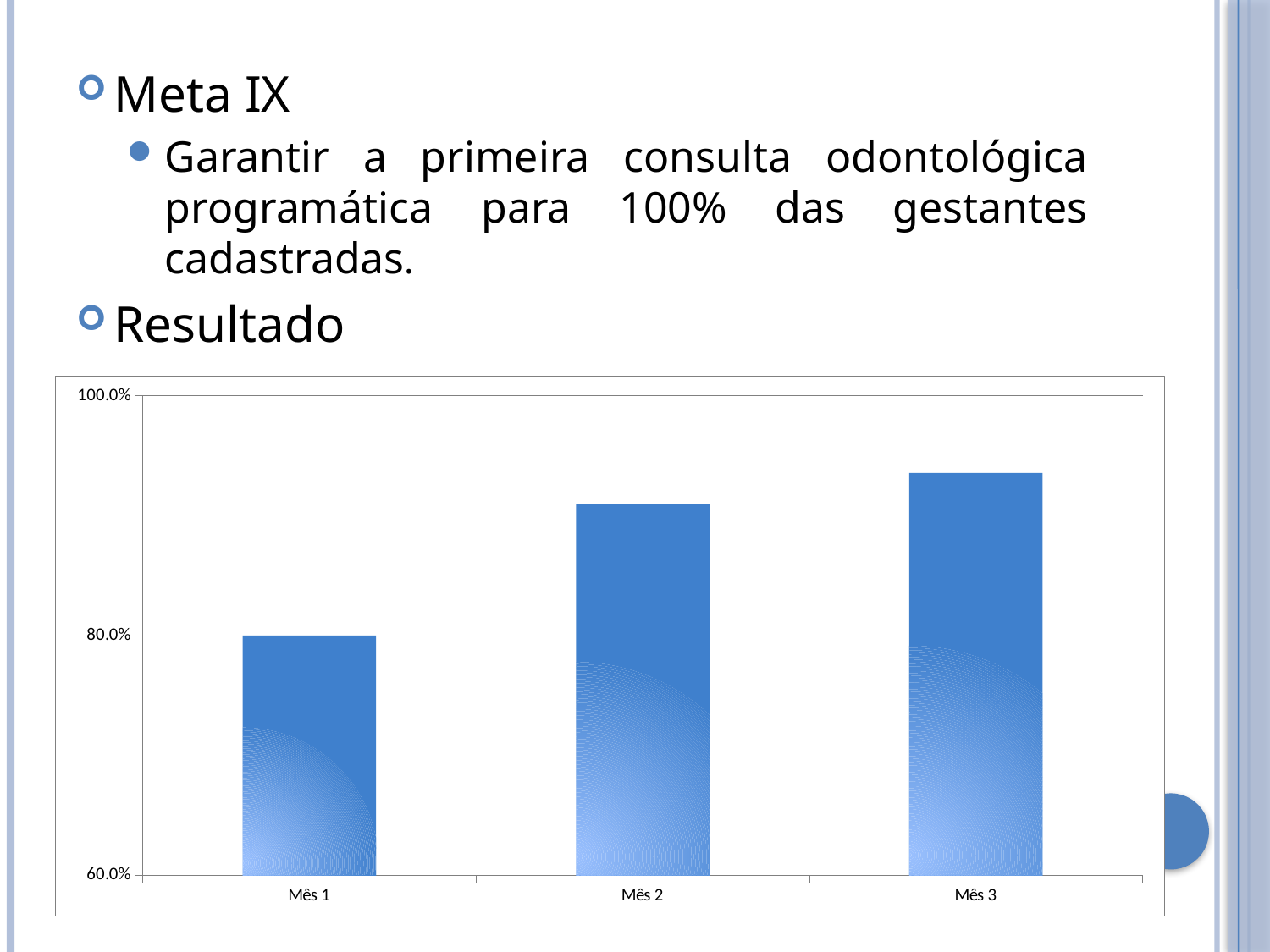
What colour are the bars in the chart? blue How many categories (months) are shown on the x axis of the chart? 3 Which month has the highest value in the chart? Mês 3 Which month has the lowest value in the chart? Mês 1 What is the value for Mês 1 in the chart? 80.0% Is the value for Mês 2 greater or less than 80.0%? greater What is the lowest value shown on the y axis of the chart? 60.0% Is the value for Mês 3 greater or less than 80.0%? greater Which is larger, the value for Mês 1 or the value for Mês 2? Mês 2 Is the value for Mês 3 greater or less than 100.0%? less What kind of chart is shown on the slide? bar chart Do the values rise or fall from Mês 1 to Mês 3? rise